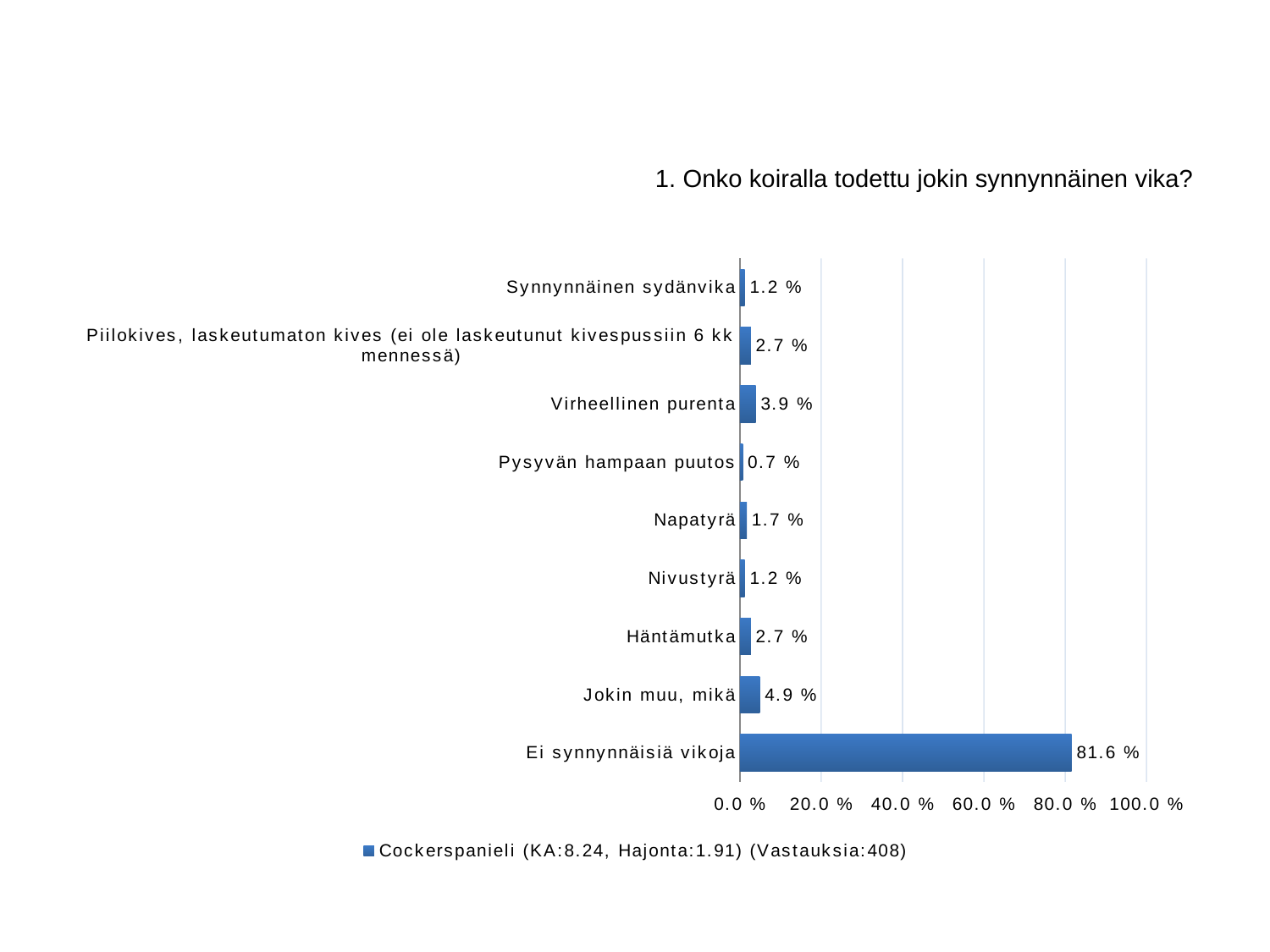
What is the value for Jokin muu, mikä? 4.9 % Is the value for Ei synnynnäisiä vikoja greater or less than 80.0 %? greater Which category has the lowest value? Pysyvän hampaan puutos What kind of chart is shown on the slide? bar chart What is the value for Pysyvän hampaan puutos? 0.7 % How many categories are shown on the chart? 9 Which is larger, the value for Häntämutka or the value for Napatyrä? Häntämutka What is the value for Virheellinen purenta? 3.9 % What is the title of the chart? 1. Onko koiralla todettu jokin synnynnäinen vika? What is the difference between the values for Jokin muu, mikä and Virheellinen purenta? 1.0 % What is the value for Ei synnynnäisiä vikoja? 81.6 % Which category has the highest value? Ei synnynnäisiä vikoja